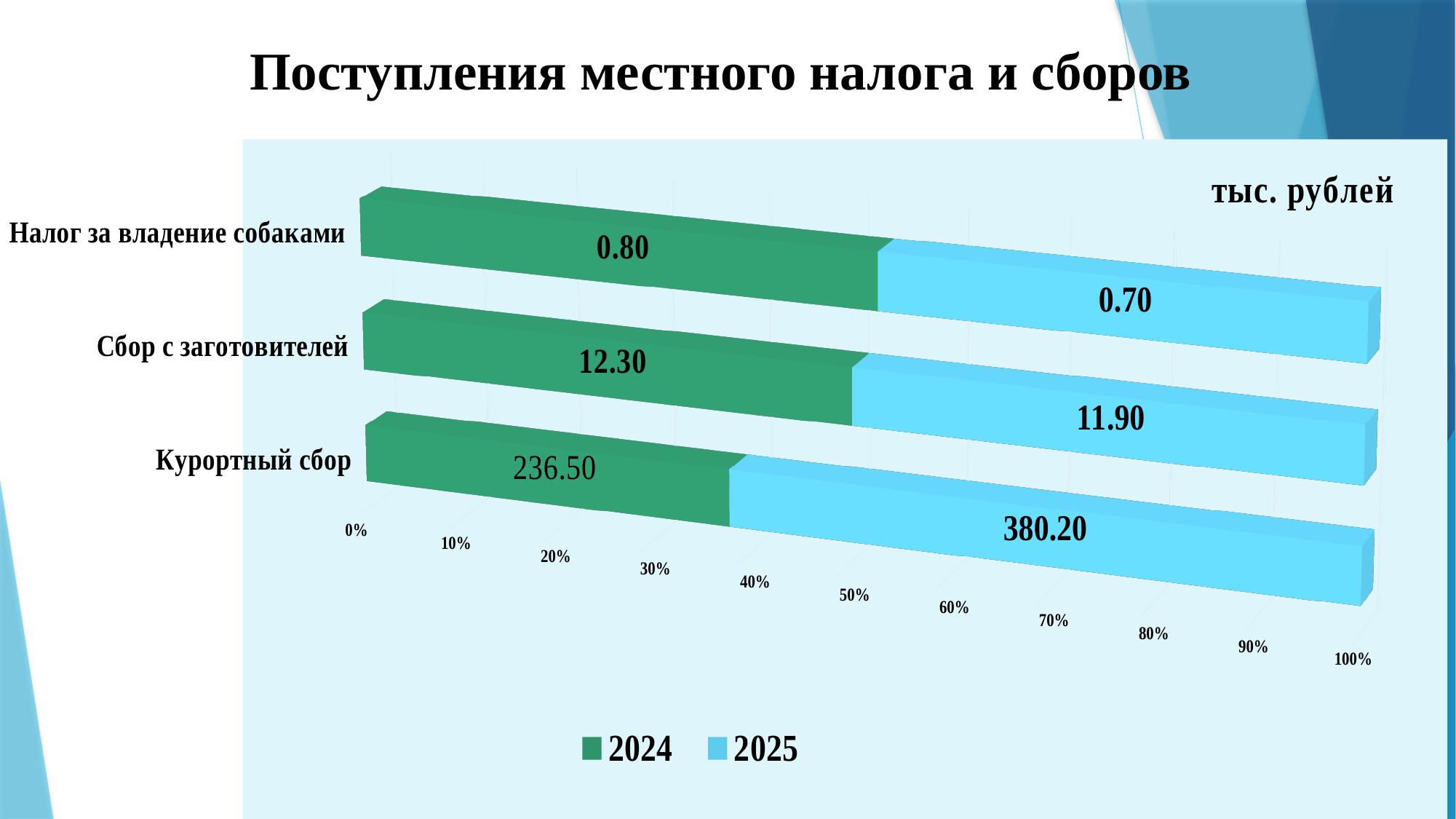
What is the 2025 value for Сбор с заготовителей? 11.90 For Курортный сбор, which year has the larger value, 2024 or 2025? 2025 What is the title of the chart on the slide? тыс. рублей How many categories are shown in the chart? 3 What is the 2025 value for Налог за владение собаками? 0.70 What is the 2024 value for Курортный сбор? 236.50 What is the difference between the 2024 and 2025 values for Сбор с заготовителей? 0.40 Which category has the lowest 2024 value? Налог за владение собаками Which category has the highest 2025 value? Курортный сбор What is the difference between the 2025 and 2024 values for Курортный сбор? 143.70 How many series does the legend list? 2 What kind of chart is shown on the slide? Stacked bar chart